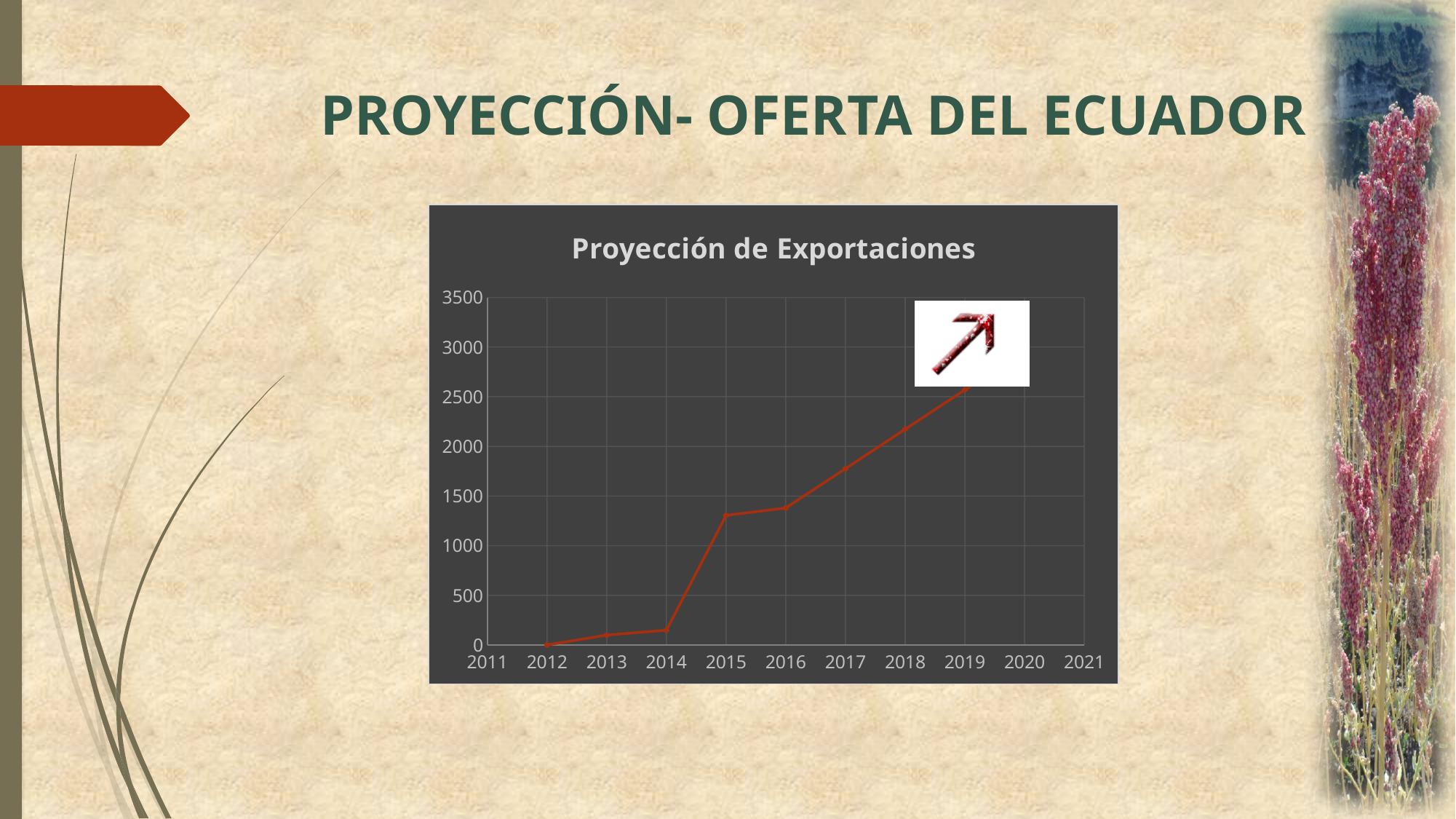
Is the value for 2014 greater or less than 500? less Is the value for 2017 greater or less than 1500? greater Is the value for 2018 greater or less than 2000? greater Do the values generally rise or fall from 2012 to 2019? rise Which year has the larger value, 2014 or 2015? 2015 Which year has the lowest plotted value? 2012 What is the title of the chart? Proyección de Exportaciones What kind of chart is shown on the slide? line chart